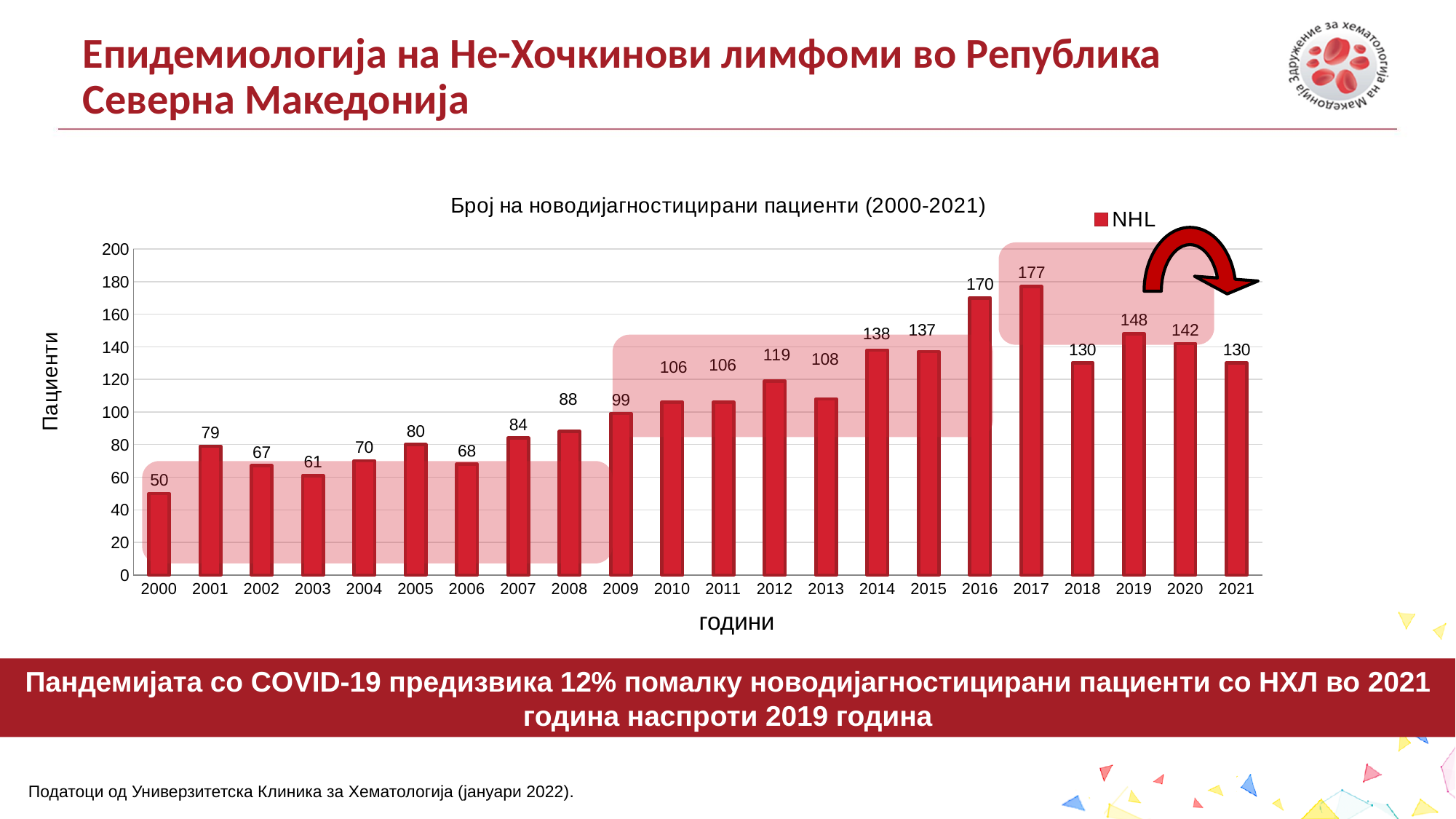
What is the difference between the values for 2019 and 2021? 18 What series name does the legend show? NHL What is the number of newly diagnosed patients in 2017? 177 Is the value for 2012 greater or less than 100? greater What is the difference between the values for 2017 and 2016? 7 How many years are shown on the x axis? 22 Which year has the lowest number of newly diagnosed patients? 2000 Which year has the highest number of newly diagnosed patients? 2017 What is the value for 2021? 130 What is the value for 2009? 99 What type of chart is shown on the slide? bar chart Which is larger, the value for 2014 or the value for 2015? 2014